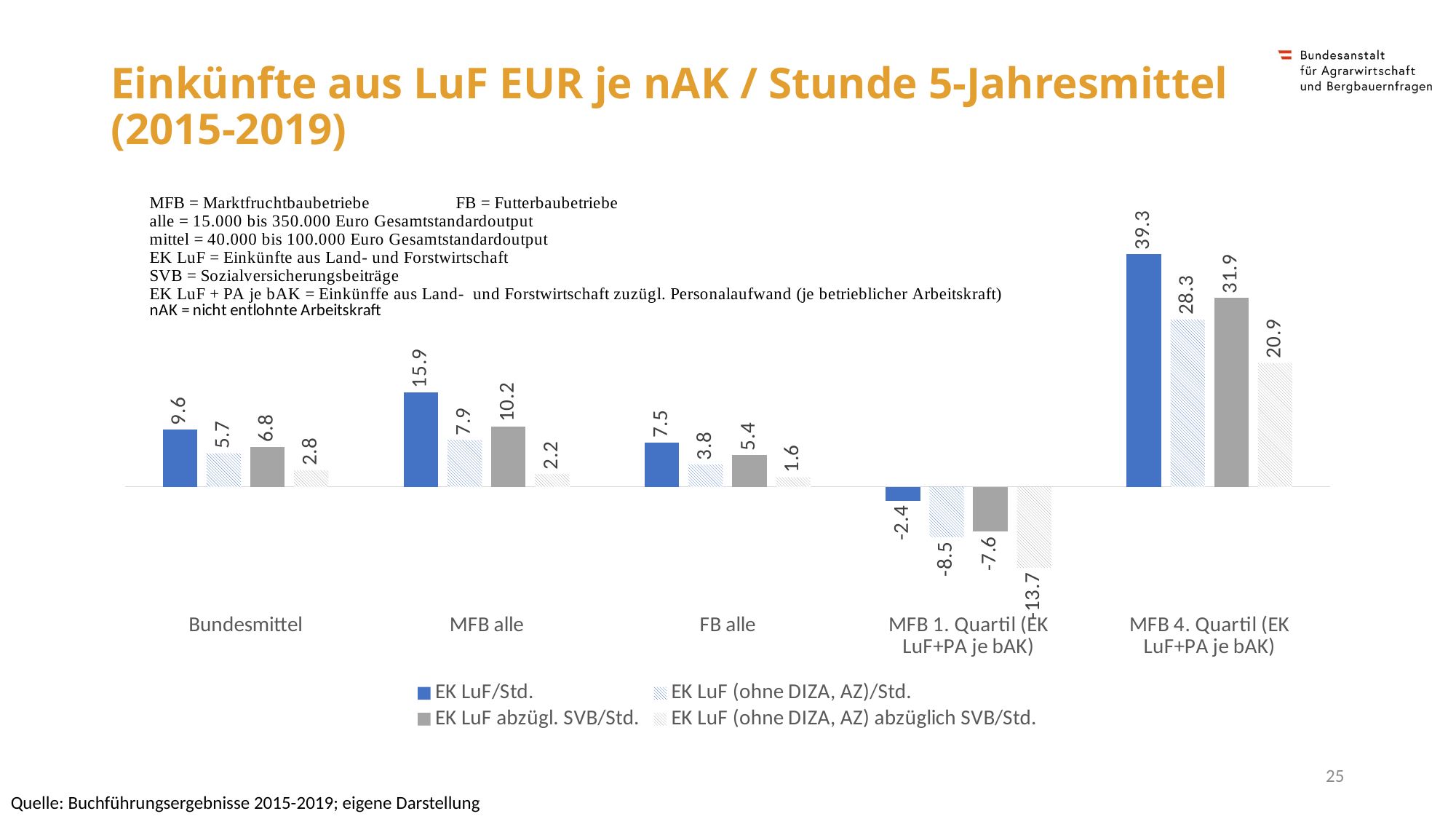
Which category has the highest value for EK LuF/Std.? MFB 4. Quartil (EK LuF+PA je bAK) How many series does the legend list? 4 What kind of chart is shown on the slide? Bar chart What is the value of EK LuF (ohne DIZA, AZ) abzüglich SVB/Std. for MFB 1. Quartil (EK LuF+PA je bAK)? -13.7 What is the value of EK LuF/Std. for Bundesmittel? 9.6 Which is larger for MFB alle: EK LuF (ohne DIZA, AZ)/Std. or EK LuF abzügl. SVB/Std.? EK LuF abzügl. SVB/Std. What is the value of EK LuF abzügl. SVB/Std. for MFB alle? 10.2 Which series is shown in solid blue in the legend? EK LuF/Std. Which category has the lowest value for EK LuF abzügl. SVB/Std.? MFB 1. Quartil (EK LuF+PA je bAK) What is the value of EK LuF (ohne DIZA, AZ)/Std. for FB alle? 3.8 What is the difference between EK LuF/Std. and EK LuF abzügl. SVB/Std. for MFB 4. Quartil (EK LuF+PA je bAK)? 7.4 How many categories are shown on the x axis? 5